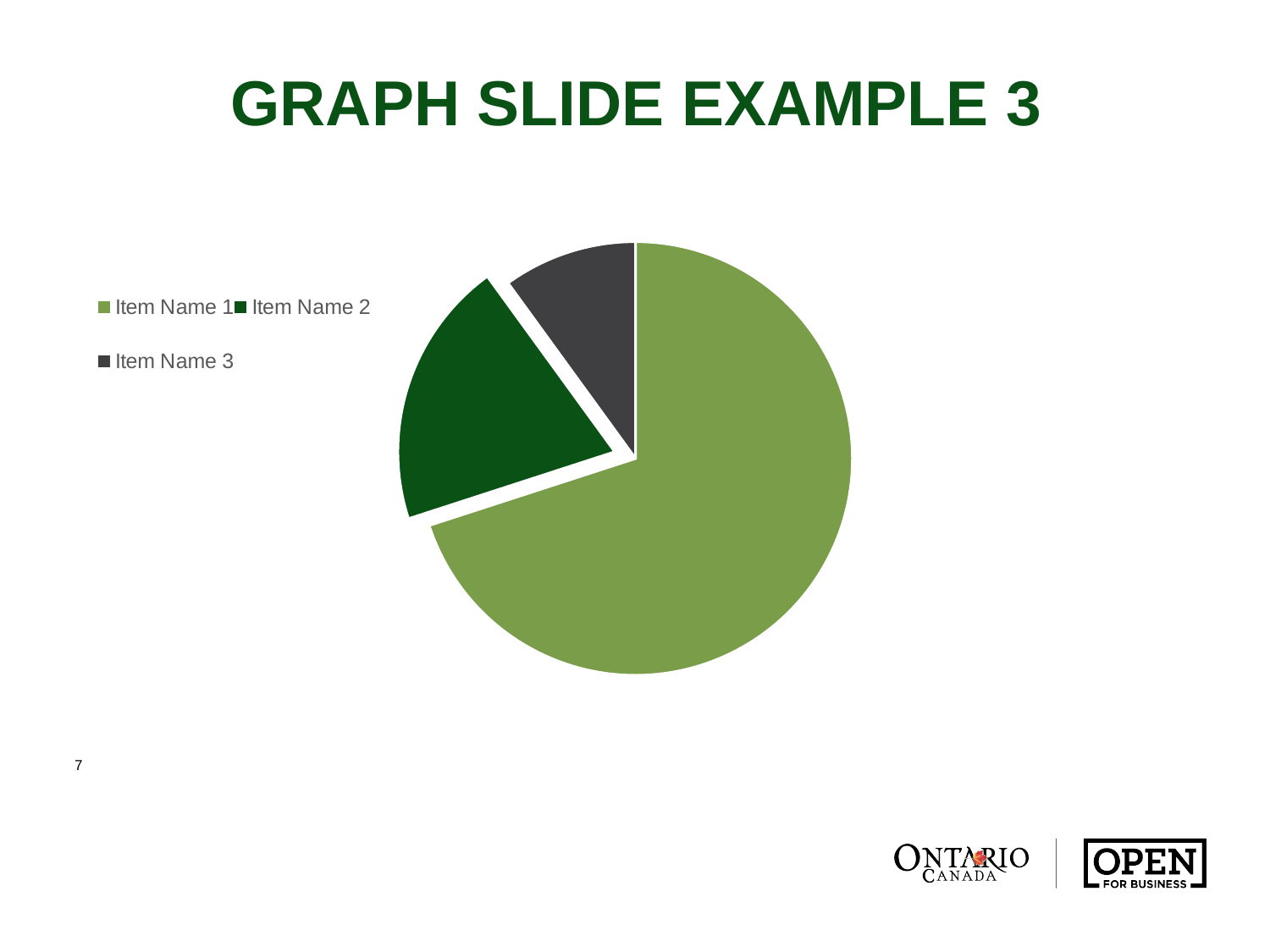
Which category has the smallest slice in the pie chart? Item Name 3 Which category has the largest slice in the pie chart? Item Name 1 Which slice is larger in the pie chart, Item Name 1 or Item Name 2? Item Name 1 Which slice is larger in the pie chart, Item Name 2 or Item Name 3? Item Name 2 What kind of chart is shown on the slide? pie chart How many entries does the legend of the pie chart list? 3 What is the title of the slide containing the pie chart? GRAPH SLIDE EXAMPLE 3 What colour is the slice for Item Name 3 in the pie chart? dark grey Does Item Name 1 take up more or less than half of the pie chart? more How many slices does the pie chart have? 3